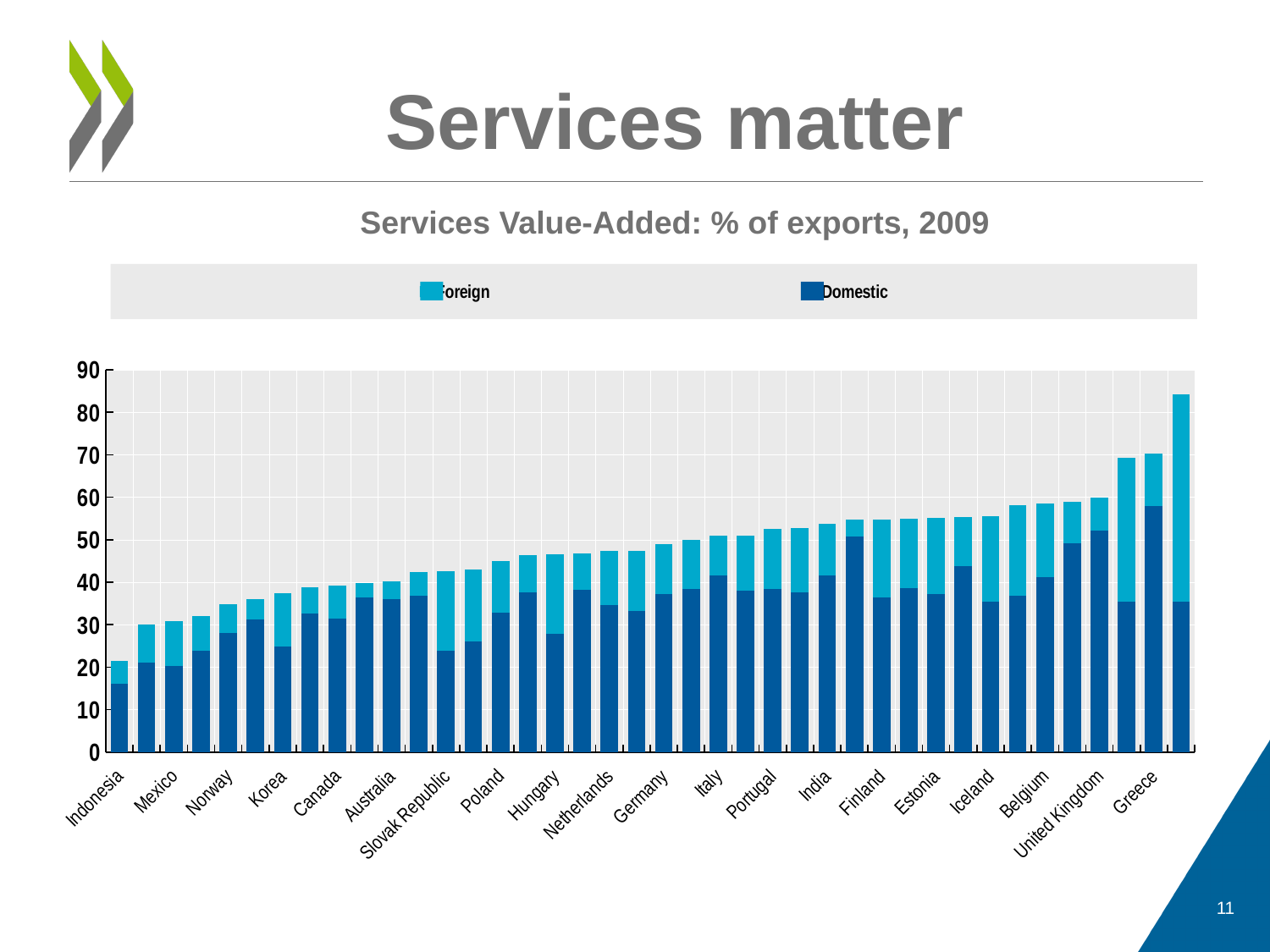
Is the total value for Poland greater or less than 40? greater Is the total value for Korea greater or less than 40? less Is the total value for Indonesia greater or less than 30? less Which has the larger total bar, Indonesia or Poland? Poland Which labelled country has the lowest total bar? Indonesia How many series does the legend list? 2 What are the two series named in the legend? Foreign and Domestic Do the total bar heights generally rise or fall from left to right along the x axis? rise What kind of chart is shown on the slide? stacked bar chart What is the title of the chart? Services Value-Added: % of exports, 2009